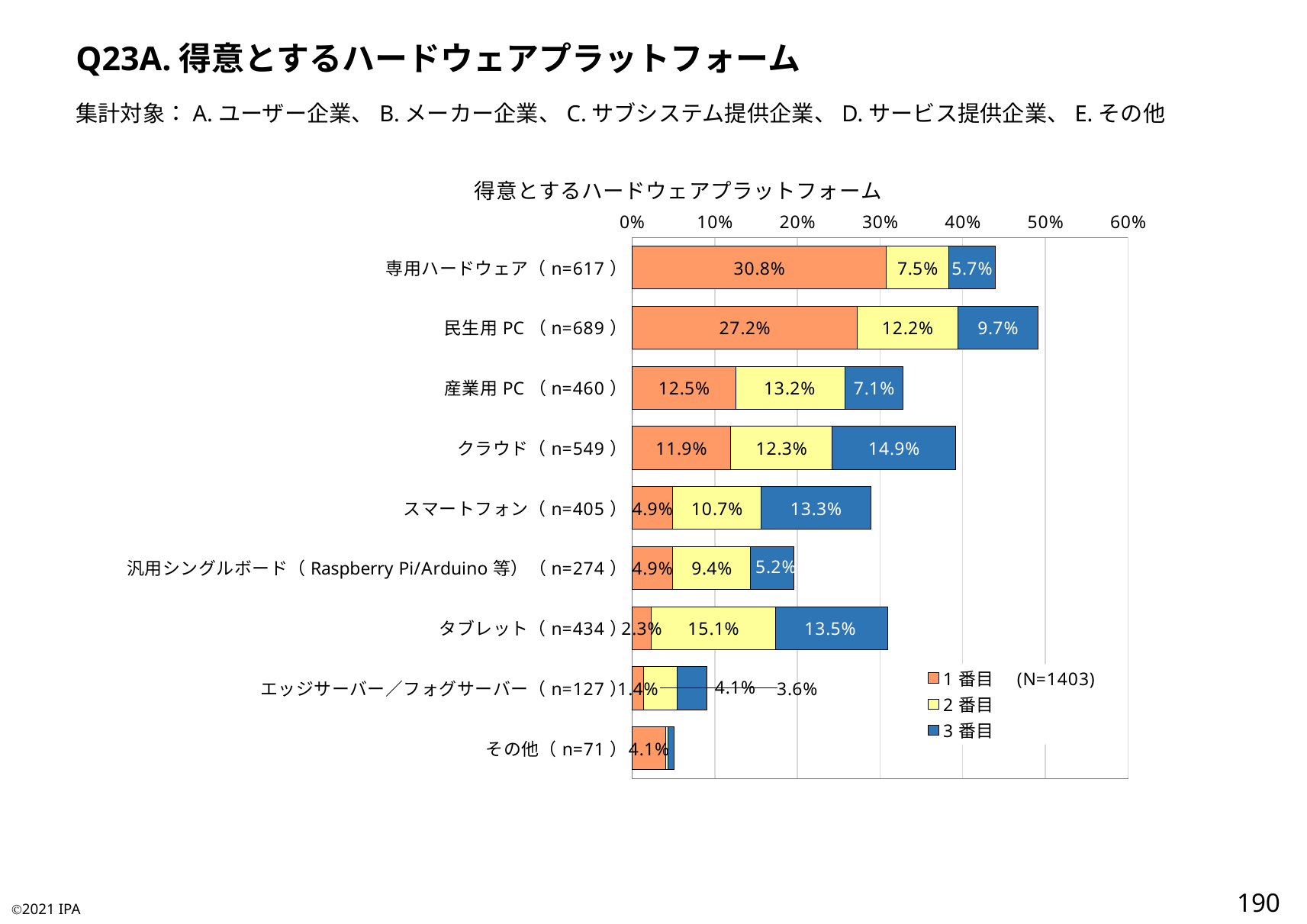
What is the 2番目 value for タブレット (n=434)? 15.1% Which category has the highest 1番目 value? 専用ハードウェア (n=617) How many categories (hardware platforms) are plotted on the chart? 9 What is the total of the stacked bar for 民生用PC (n=689)? 49.1% What is the difference between the 1番目 values for 専用ハードウェア and 民生用PC? 3.6% Which category has the lowest 1番目 value? エッジサーバー／フォグサーバー (n=127) What is the 1番目 value for 専用ハードウェア (n=617)? 30.8% How many series does the legend list? 3 Which is larger: the 2番目 value for 産業用PC or the 2番目 value for 民生用PC? 産業用PC What kind of chart is shown on the slide? Stacked bar chart What is the 3番目 value for クラウド (n=549)? 14.9% What is the N value shown next to the legend? N=1403